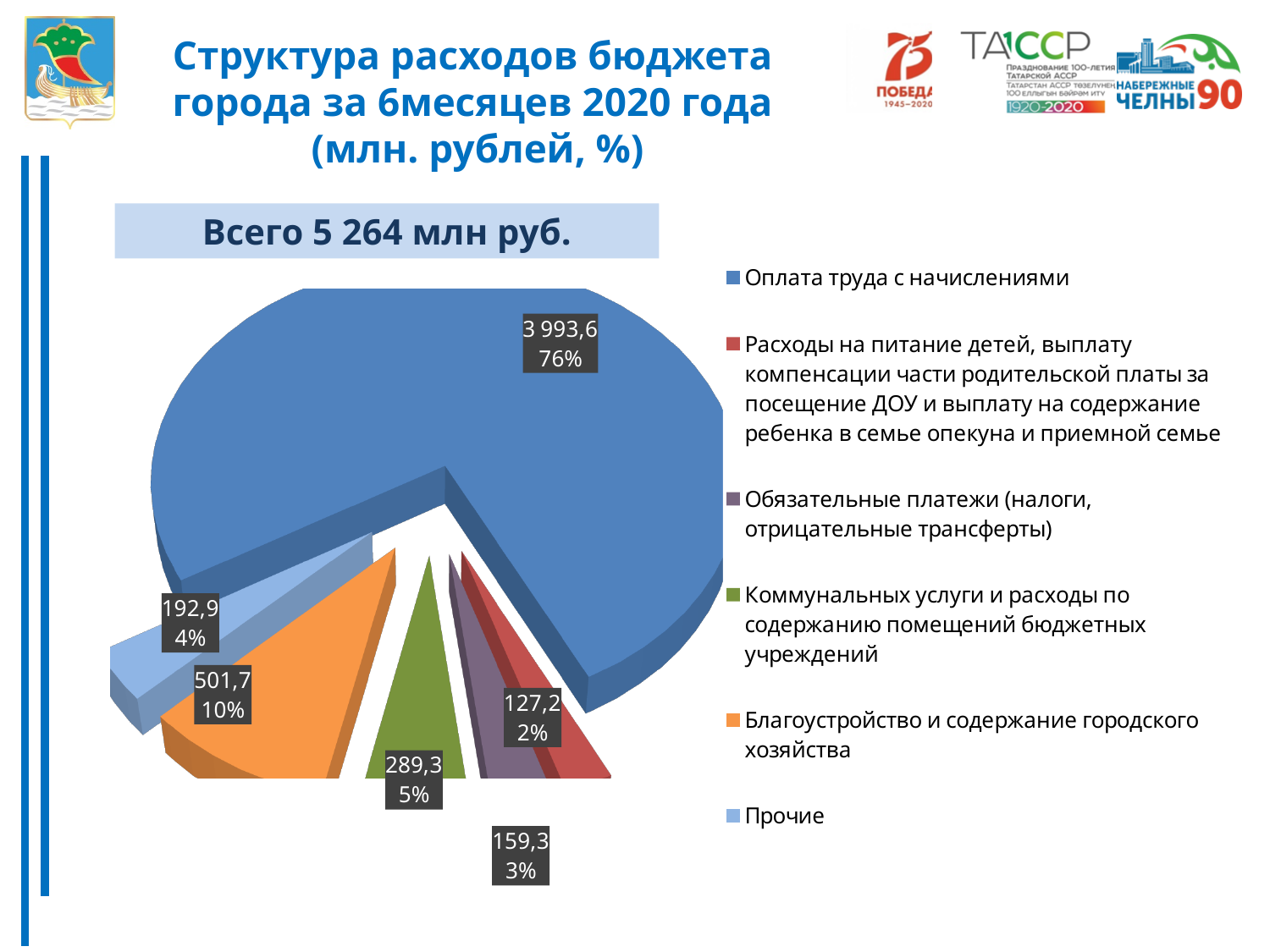
How many slices does the pie chart have? 6 Which is larger: the value for Коммунальных услуги и расходы по содержанию помещений бюджетных учреждений or the value for Обязательные платежи (налоги, отрицательные трансферты)? Коммунальных услуги и расходы по содержанию помещений бюджетных учреждений Which category has the smallest slice? Расходы на питание детей, выплату компенсации части родительской платы за посещение ДОУ и выплату на содержание ребенка в семье опекуна и приемной семье What is the value for Оплата труда с начислениями? 3 993,6 What is the value for Благоустройство и содержание городского хозяйства? 501,7 What share of the pie does Коммунальных услуги и расходы по содержанию помещений бюджетных учреждений take? 5% What kind of chart is shown on the slide? pie chart Which category has the largest slice? Оплата труда с начислениями How many entries does the legend list? 6 What is the value for Прочие? 192,9 What is the difference between the values for Благоустройство и содержание городского хозяйства and Прочие? 308,8 What share of the pie does Оплата труда с начислениями take? 76%